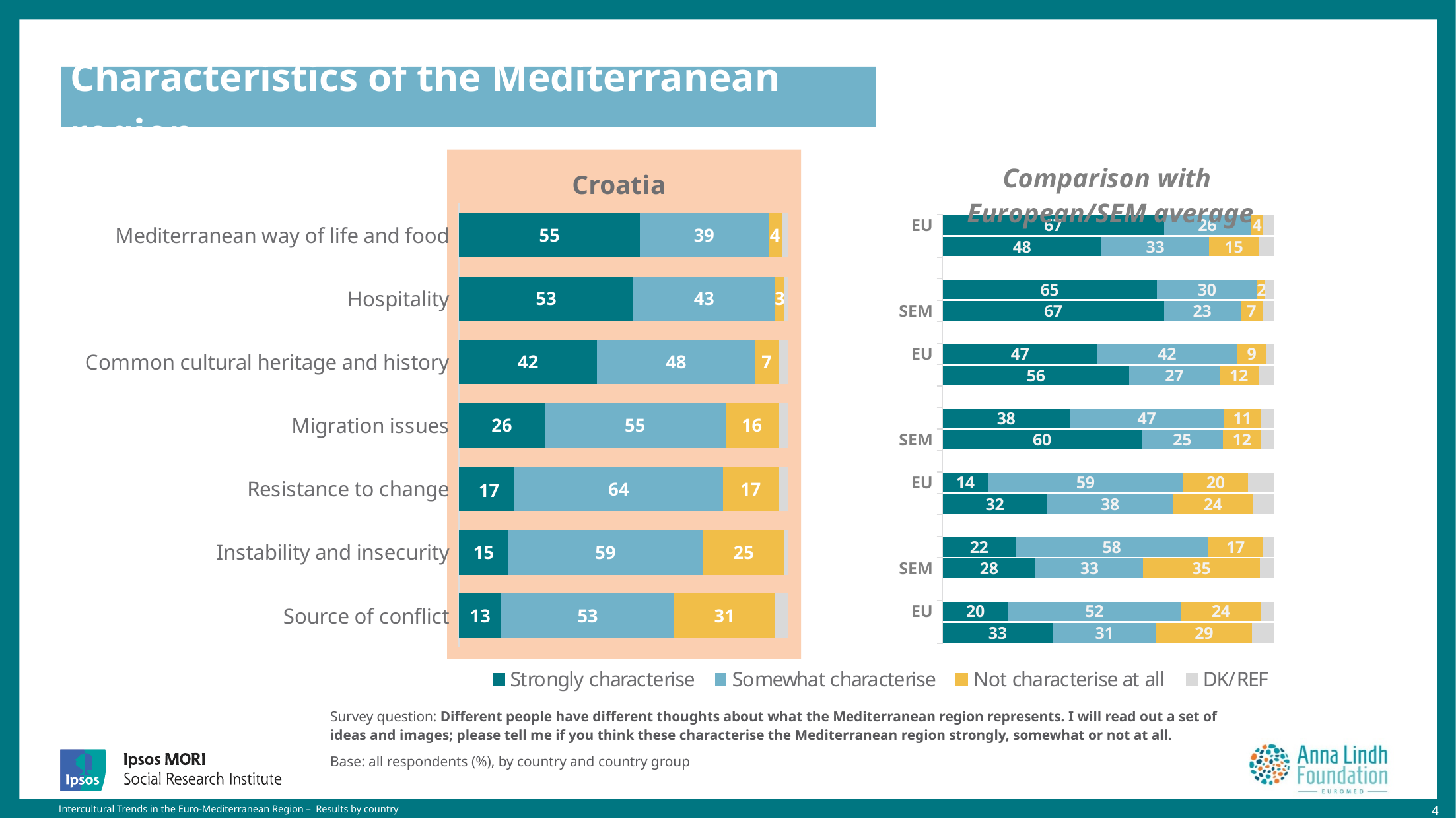
In the Croatia chart, what is the difference between the Somewhat characterise values for Resistance to change and Migration issues? 9 How many series does the legend list? 4 In the Croatia chart, which category has the highest Strongly characterise value? Mediterranean way of life and food In the Croatia chart, which has the larger Not characterise at all value: Instability and insecurity or Migration issues? Instability and insecurity How many categories are shown in the Croatia chart? 7 In the Croatia chart, what is the Somewhat characterise value for Common cultural heritage and history? 48 In the Croatia chart, which category has the lowest Strongly characterise value? Source of conflict What is the title of the chart on the left side of the slide? Croatia In the Croatia chart, what is the Not characterise at all value for Source of conflict? 31 In the Croatia chart, which category has the highest Somewhat characterise value? Resistance to change In the Croatia chart, what is the Strongly characterise value for Hospitality? 53 What kind of chart is the Croatia chart? Stacked bar chart